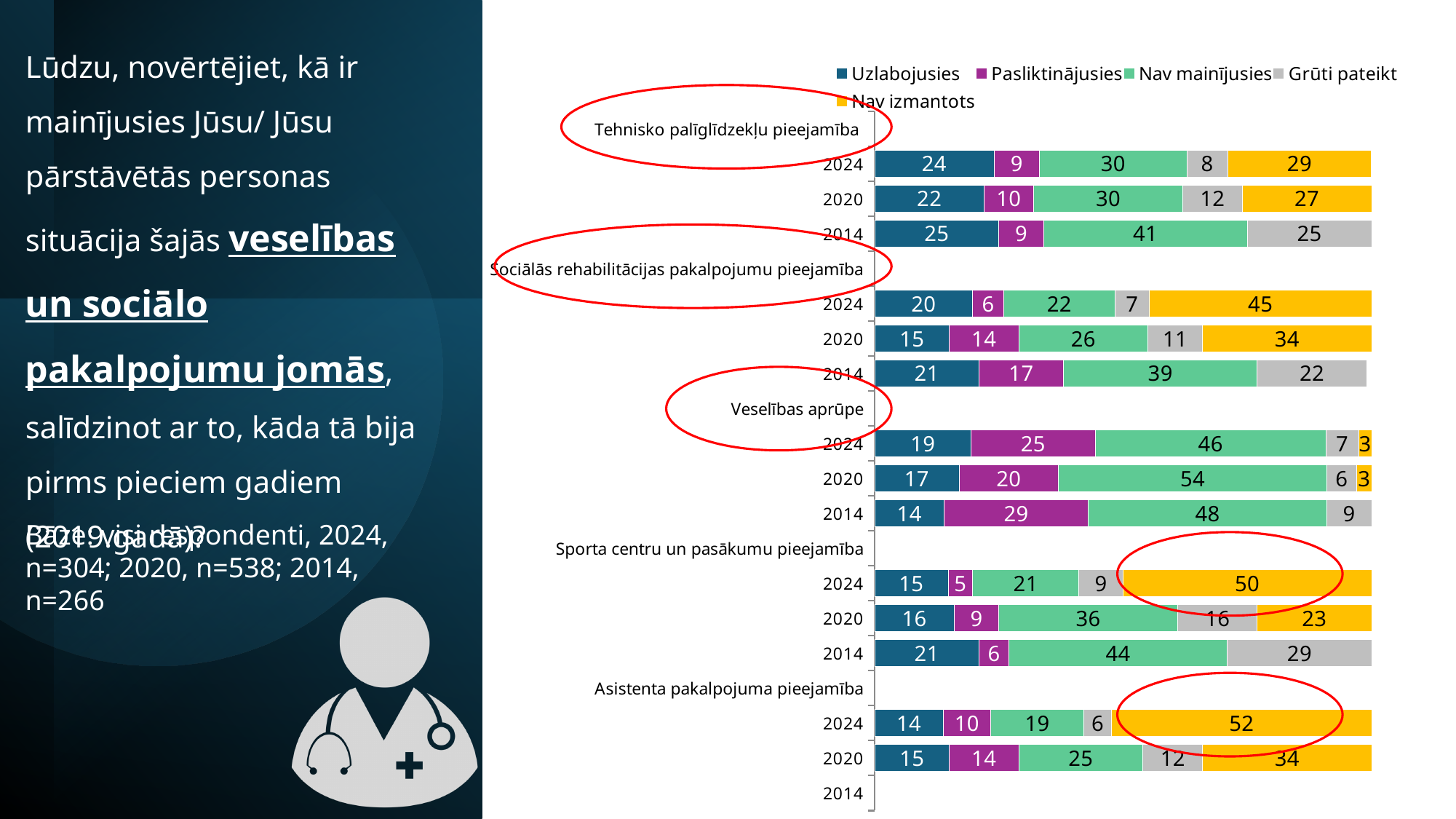
What is the value of Uzlabojusies for Tehnisko palīglīdzekļu pieejamība in 2024? 24 Which bar has the highest Nav izmantots value? Asistenta pakalpojuma pieejamība, 2024 What is the value of Nav izmantots for Sociālās rehabilitācijas pakalpojumu pieejamība in 2024? 45 What is the value of Nav mainījusies for Veselības aprūpe in 2020? 54 What is the difference between the Nav izmantots values for Sporta centru un pasākumu pieejamība in 2024 and 2020? 27 Which legend entry is shown in yellow? Nav izmantots How many service categories (groups) are shown in the chart? 5 What is the total of the stacked bar for Tehnisko palīglīdzekļu pieejamība in 2024? 100 Which is larger: Pasliktinājusies for Veselības aprūpe in 2014 or in 2024? 2014 What kind of chart is shown on the slide? Stacked bar chart How many series does the legend list? 5 What is the value of Grūti pateikt for Sporta centru un pasākumu pieejamība in 2014? 29